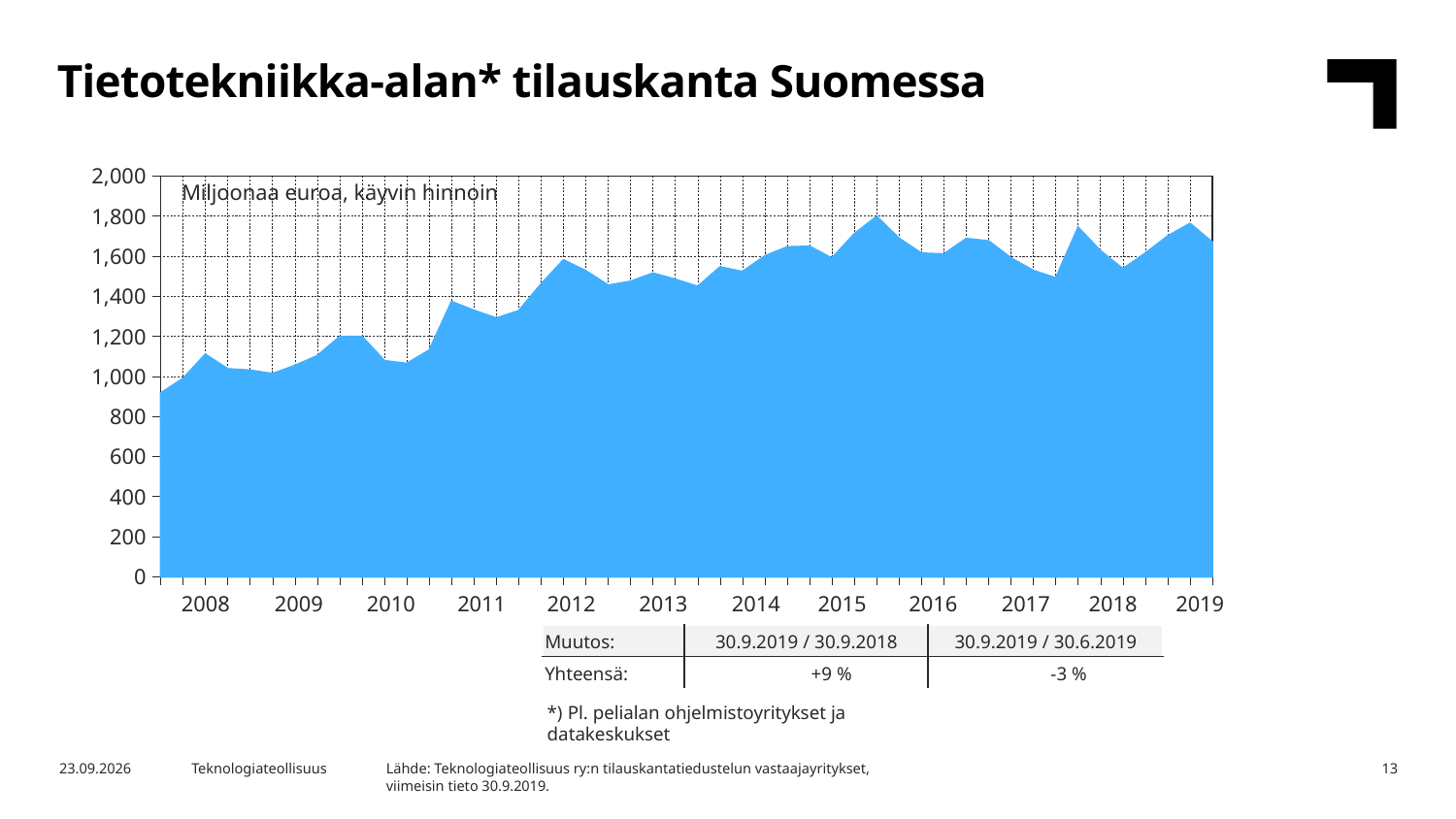
Which is larger, the value at the start of 2010 or the value at the start of 2014? start of 2014 Overall, do the values rise or fall from 2008 to 2019? rise Is the value at the end of 2019 greater or less than 1,600? greater How many year labels are shown on the x axis? 12 What unit is stated inside the chart area? Miljoonaa euroa, käyvin hinnoin Which is larger, the value at the start of 2008 or the value at the end of 2019? end of 2019 What kind of chart is shown on the slide? area chart Is the value at the start of 2011 greater or less than 1,200? greater What is the title of the chart? Tietotekniikka-alan* tilauskanta Suomessa